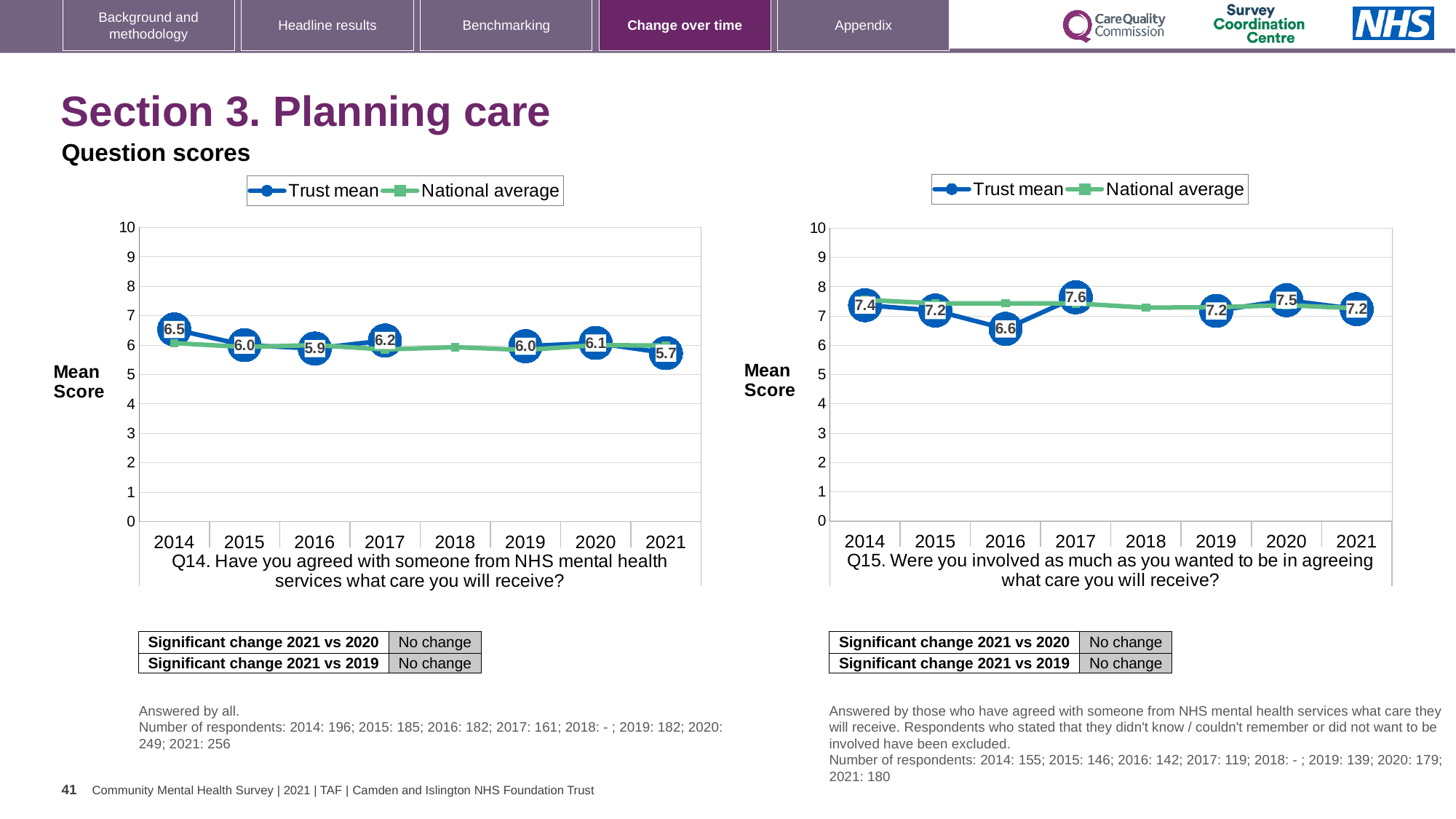
What type of chart is the Q15 chart on the right? Line chart In the Q14 chart on the left, which year has the lowest Trust mean? 2021 In the Q14 chart on the left, what is the Trust mean for 2014? 6.5 In the Q14 chart on the left, which year has the highest Trust mean? 2014 In the Q14 chart on the left, what is the Trust mean for 2021? 5.7 In the Q15 chart on the right, which is larger, the Trust mean in 2016 or in 2020? 2020 In the Q14 chart on the left, what is the difference between the Trust mean in 2014 and in 2021? 0.8 In the Q15 chart on the right, what is the difference between the Trust mean in 2017 and in 2016? 1.0 In the Q15 chart on the right, is the National average for 2018 greater or less than 6? greater How many series does the legend of the Q14 chart on the left list? 2 In the Q15 chart on the right, which year has the lowest Trust mean? 2016 In the Q15 chart on the right, what is the Trust mean for 2017? 7.6